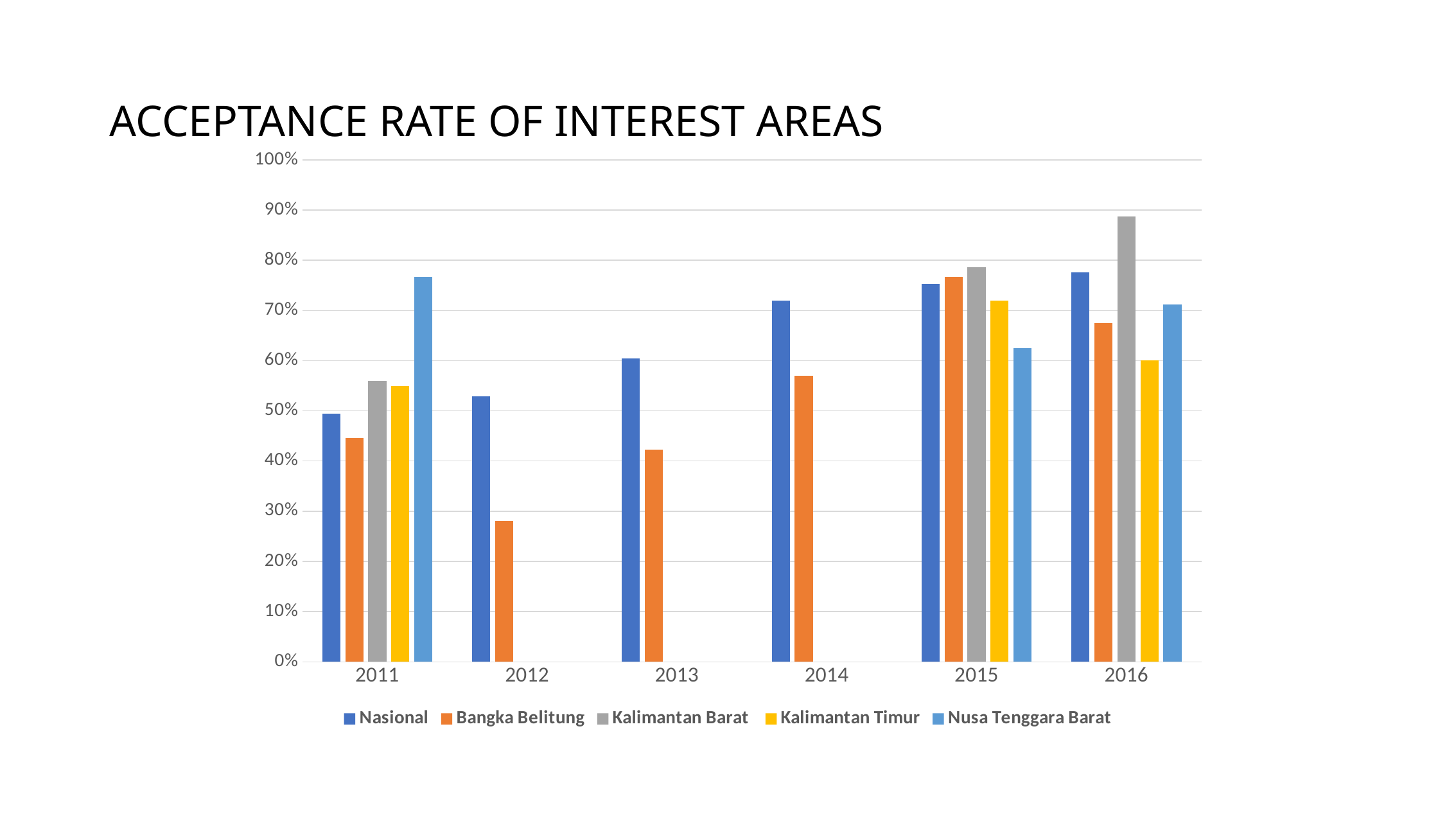
What is the title of the chart? ACCEPTANCE RATE OF INTEREST AREAS How many series does the legend list? 5 Is the value for Nusa Tenggara Barat in 2011 greater or less than 70%? greater Which series has the highest bar in 2016? Kalimantan Barat What kind of chart is shown on the slide? bar chart In 2011, which is larger: Nasional or Nusa Tenggara Barat? Nusa Tenggara Barat How many years are shown on the x axis? 6 Is the value for Bangka Belitung in 2012 greater or less than 30%? less Is the value for Kalimantan Barat in 2016 greater or less than 80%? greater Does the Nasional series rise or fall from 2011 to 2016? rise In which year is the Bangka Belitung value lowest? 2012 Which series has the lowest bar in 2015? Nusa Tenggara Barat